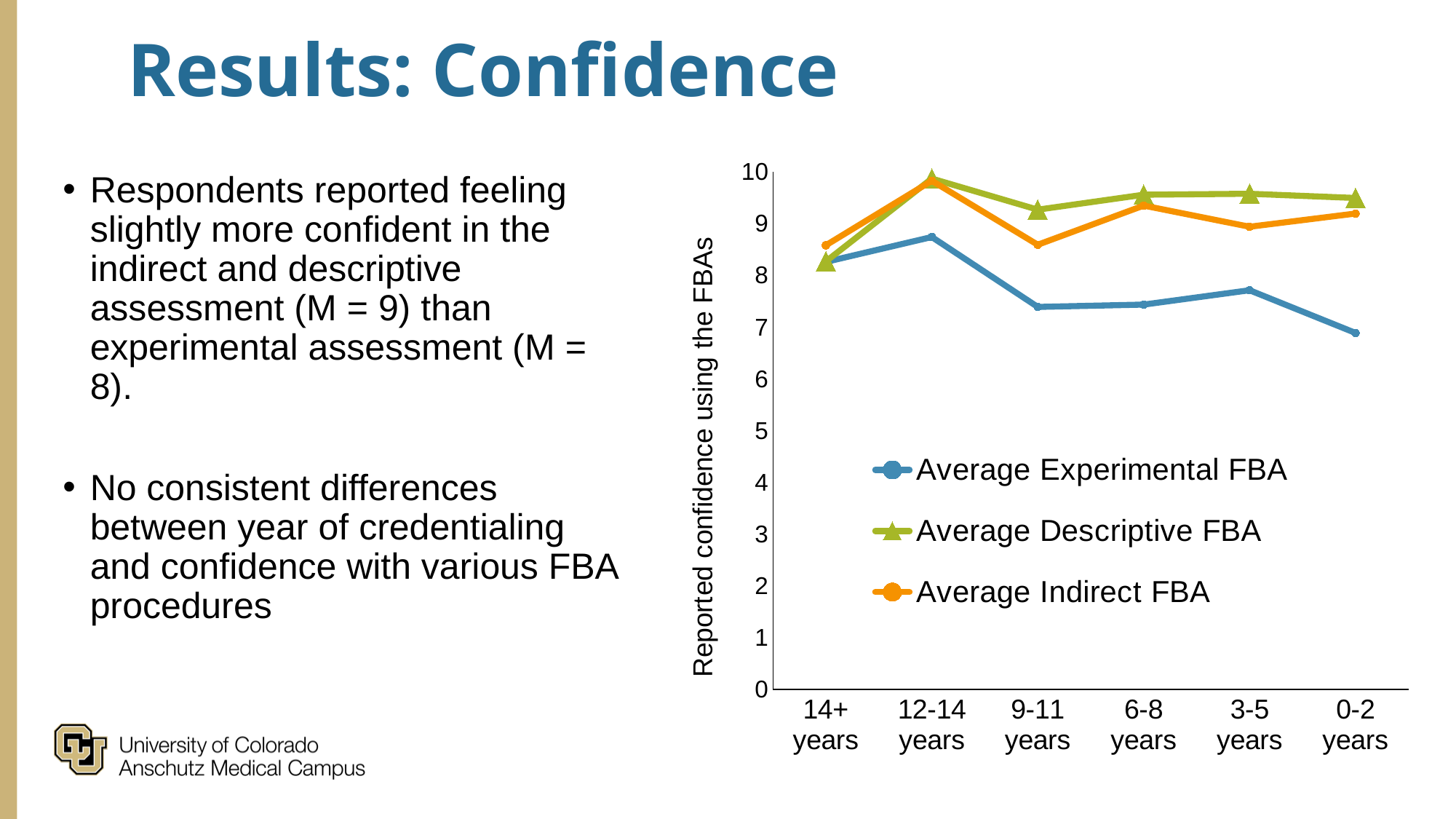
How many year-of-credentialing categories are shown on the x axis? 6 Is the Average Indirect FBA value for 9-11 years greater or less than 9? less At 9-11 years, which is larger: Average Descriptive FBA or Average Indirect FBA? Average Descriptive FBA What colour is the Average Indirect FBA line? orange Is the Average Descriptive FBA value for 12-14 years greater or less than 9? greater Which category has the lowest Average Experimental FBA value? 0-2 years Which category has the highest Average Experimental FBA value? 12-14 years Is the Average Experimental FBA value for 0-2 years greater or less than 8? less What is the title of the chart's y axis? Reported confidence using the FBAs Does the Average Experimental FBA line generally rise or fall from 14+ years to 0-2 years? fall What kind of chart is shown on the slide? line chart How many series does the chart's legend list? 3